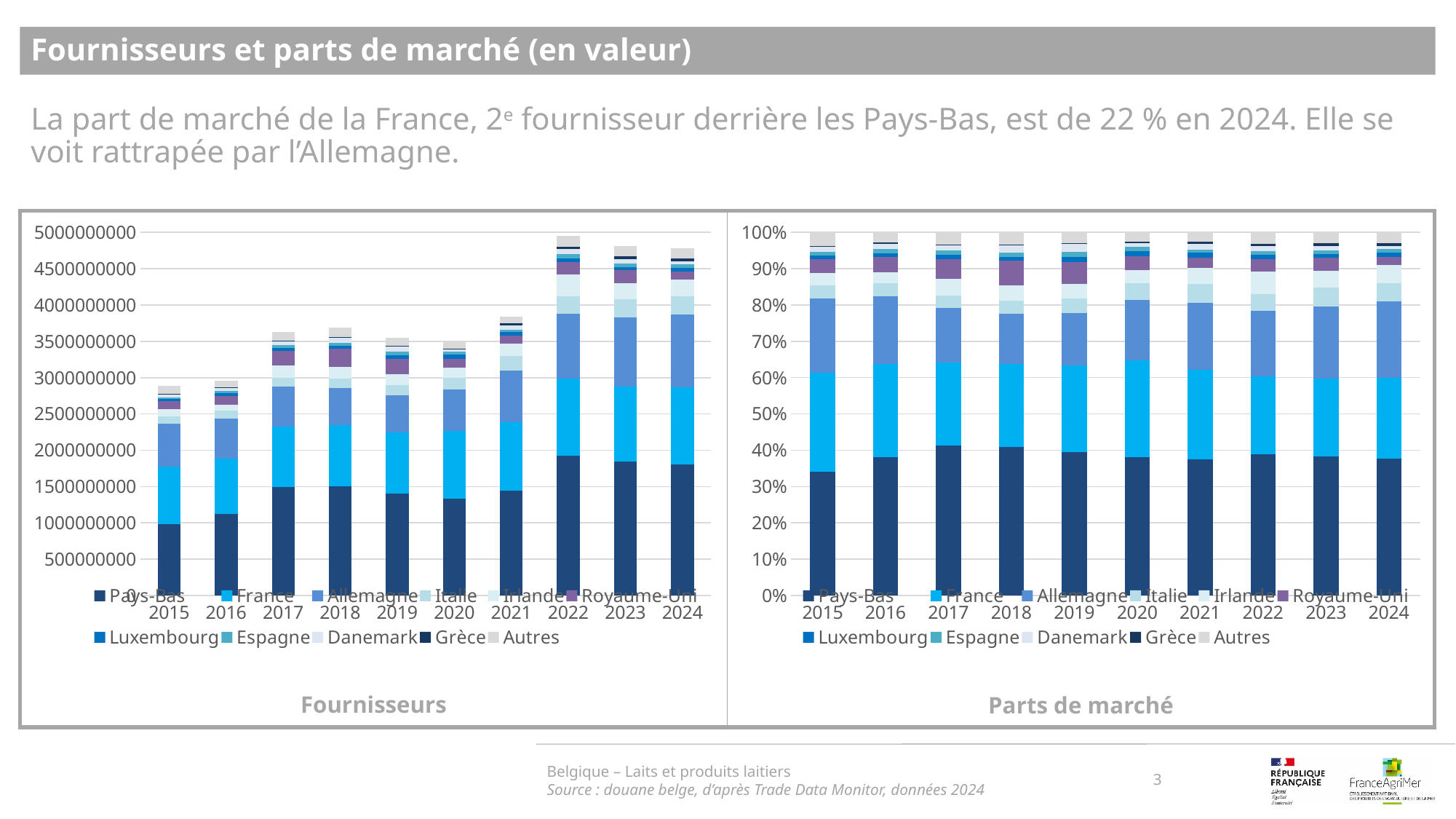
In the 'Parts de marché' chart, does the Pays-Bas share rise or fall from 2015 to 2017? rise In the 'Fournisseurs' chart, which is larger in 2024: the Pays-Bas segment or the France segment? Pays-Bas How many years are shown on the x axis of the 'Parts de marché' chart? 10 In the 'Fournisseurs' chart, is the Pays-Bas value for 2022 greater or less than 1500000000? greater In the 'Fournisseurs' chart, is the total of the 2022 bar greater or less than 4500000000? greater How many series does the legend of the 'Fournisseurs' chart list? 11 What kind of chart is the 'Fournisseurs' chart on the left? Stacked bar chart In the 'Fournisseurs' chart, which year has the tallest stacked bar? 2022 In the 'Parts de marché' chart, is the Pays-Bas share for 2015 greater or less than 40%? less What is the title of the slide containing the two charts? Fournisseurs et parts de marché (en valeur) In the 'Fournisseurs' chart, which year has the shortest stacked bar? 2015